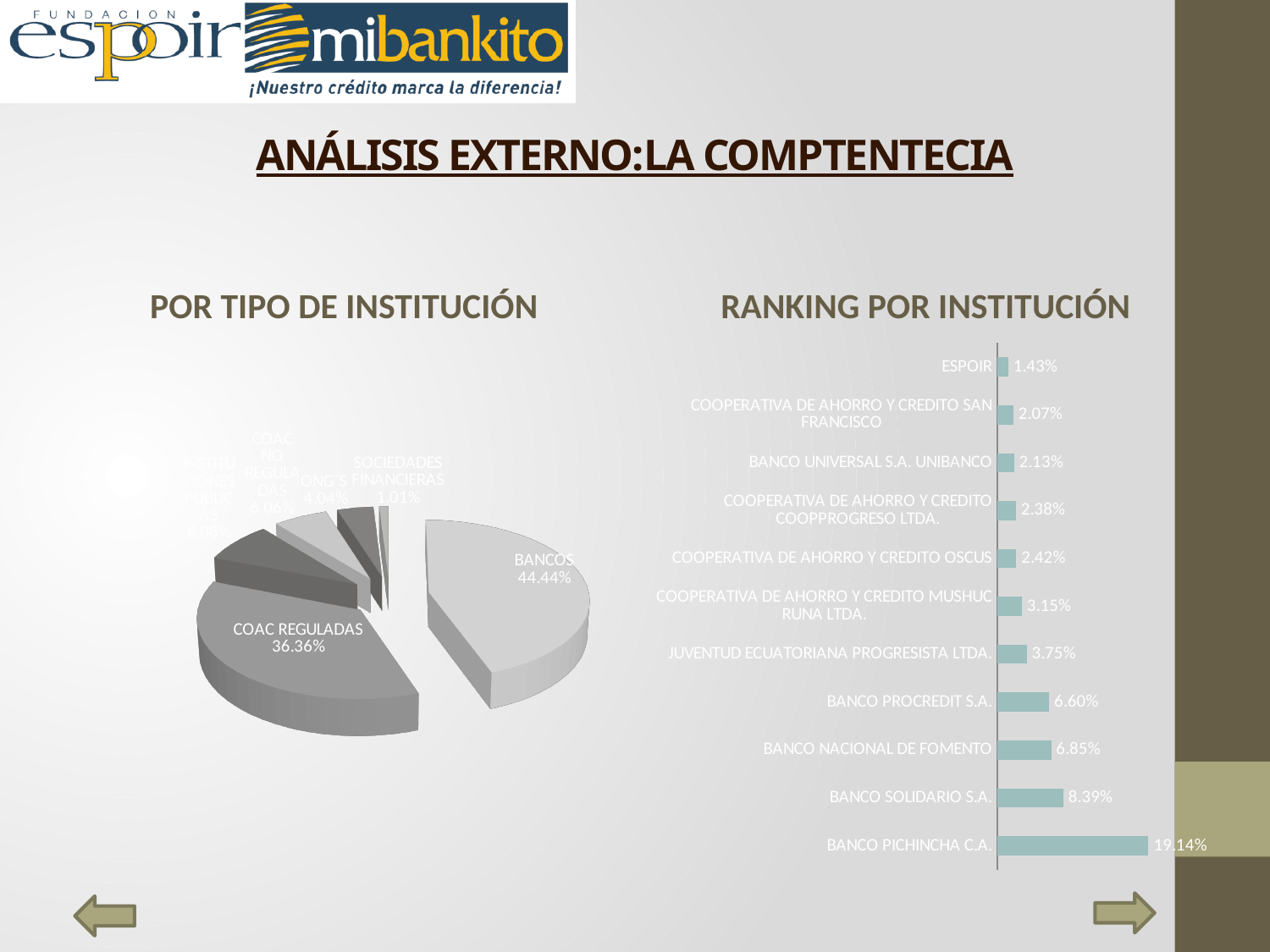
In the 'POR TIPO DE INSTITUCIÓN' chart, what share does COAC REGULADAS have? 36.36% What kind of chart is 'POR TIPO DE INSTITUCIÓN'? Pie chart In the 'RANKING POR INSTITUCIÓN' chart, what is the difference between BANCO PICHINCHA C.A. and BANCO SOLIDARIO S.A.? 10.75% In the 'RANKING POR INSTITUCIÓN' chart, what is the value for ESPOIR? 1.43% How many institutions are shown in the 'RANKING POR INSTITUCIÓN' chart? 11 In the 'POR TIPO DE INSTITUCIÓN' chart, what share does BANCOS have? 44.44% In the 'RANKING POR INSTITUCIÓN' chart, which institution has the highest value? BANCO PICHINCHA C.A. What kind of chart is 'RANKING POR INSTITUCIÓN'? Bar chart In the 'RANKING POR INSTITUCIÓN' chart, what is the value for BANCO PICHINCHA C.A.? 19.14% In the 'RANKING POR INSTITUCIÓN' chart, what is the value for BANCO SOLIDARIO S.A.? 8.39% In the 'RANKING POR INSTITUCIÓN' chart, which institution has the lowest value? ESPOIR In the 'RANKING POR INSTITUCIÓN' chart, which is larger: BANCO PROCREDIT S.A. or JUVENTUD ECUATORIANA PROGRESISTA LTDA.? BANCO PROCREDIT S.A.